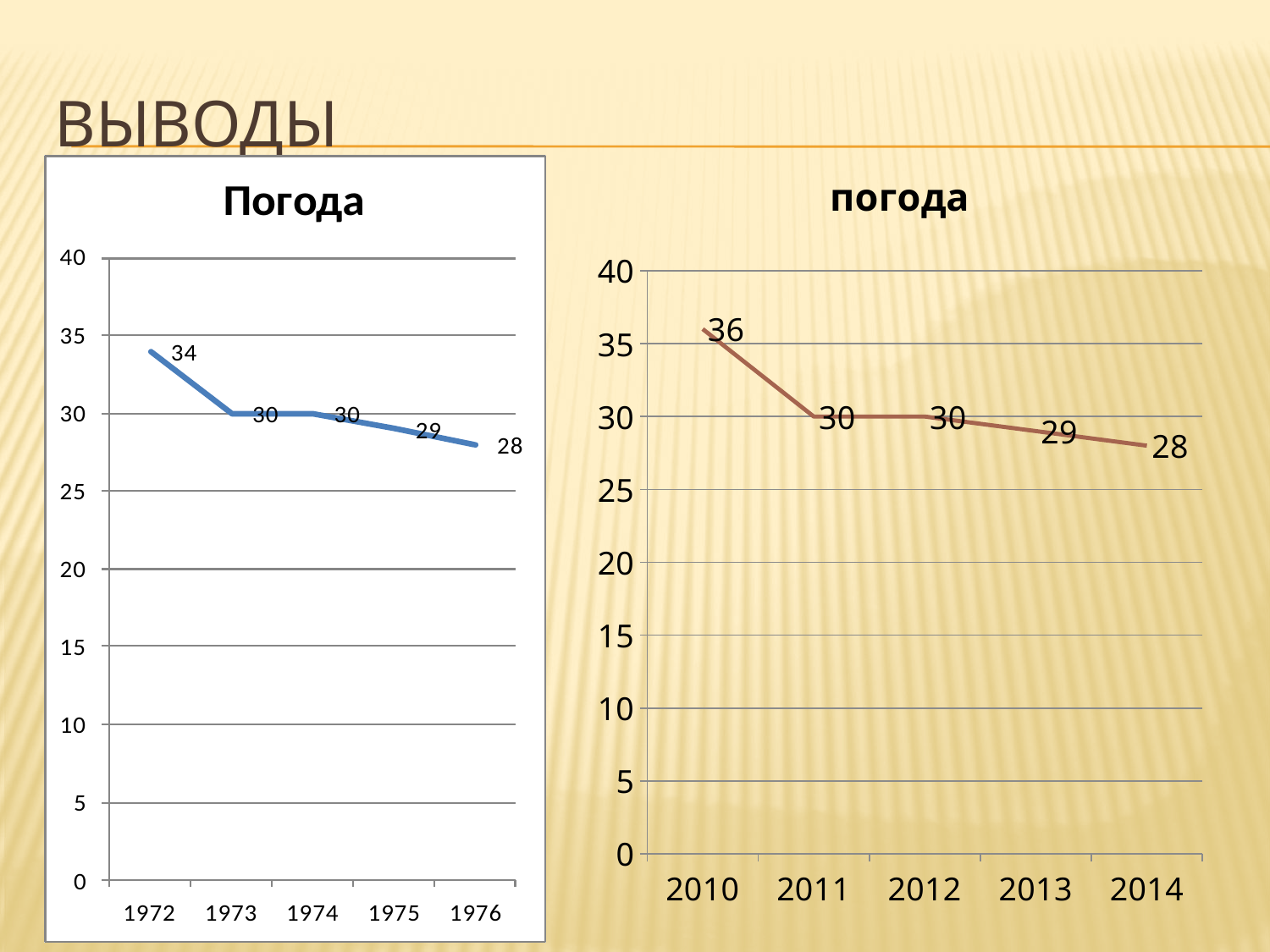
In the right chart (2010–2014), do the values rise or fall from 2010 to 2014? fall What kind of chart is the left chart (1972–1976)? line chart In the left chart (1972–1976), what is the difference between the values for 1972 and 1973? 4 In the left chart (1972–1976), which year has the highest value? 1972 In the right chart (2010–2014), what is the value for 2010? 36 How many data points are plotted in the right chart (2010–2014)? 5 In the right chart (2010–2014), what is the difference between the values for 2010 and 2014? 8 In the right chart (2010–2014), what is the value for 2013? 29 In the right chart (2010–2014), which year has the lowest value? 2014 In the left chart (1972–1976), what is the value for 1976? 28 In the left chart (1972–1976), which is larger, the value for 1975 or the value for 1976? 1975 In the left chart (1972–1976), what is the value for 1972? 34